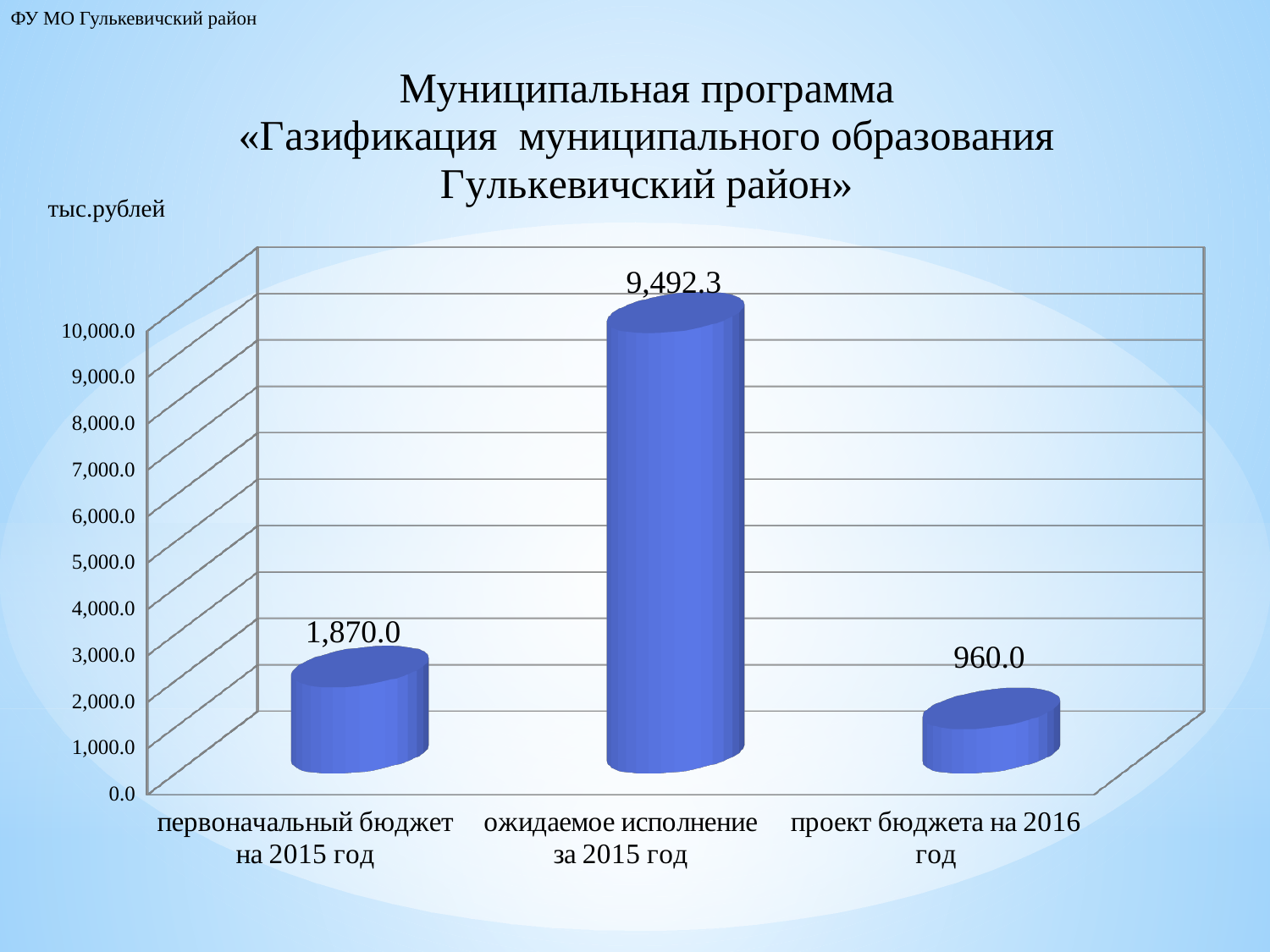
Is the value for «ожидаемое исполнение за 2015 год» greater or less than 9,000.0? greater Which is larger: the value for «первоначальный бюджет на 2015 год» or for «проект бюджета на 2016 год»? первоначальный бюджет на 2015 год What is the difference between the values for «ожидаемое исполнение за 2015 год» and «первоначальный бюджет на 2015 год»? 7,622.3 What is the value for «первоначальный бюджет на 2015 год»? 1,870.0 What kind of chart is shown on the slide? bar chart What is the value for «ожидаемое исполнение за 2015 год»? 9,492.3 How many categories are shown on the chart? 3 Which category has the lowest value? проект бюджета на 2016 год What is the difference between the values for «первоначальный бюджет на 2015 год» and «проект бюджета на 2016 год»? 910.0 What is the value for «проект бюджета на 2016 год»? 960.0 What unit is indicated for the values on the chart? тыс.рублей Which category has the highest value? ожидаемое исполнение за 2015 год